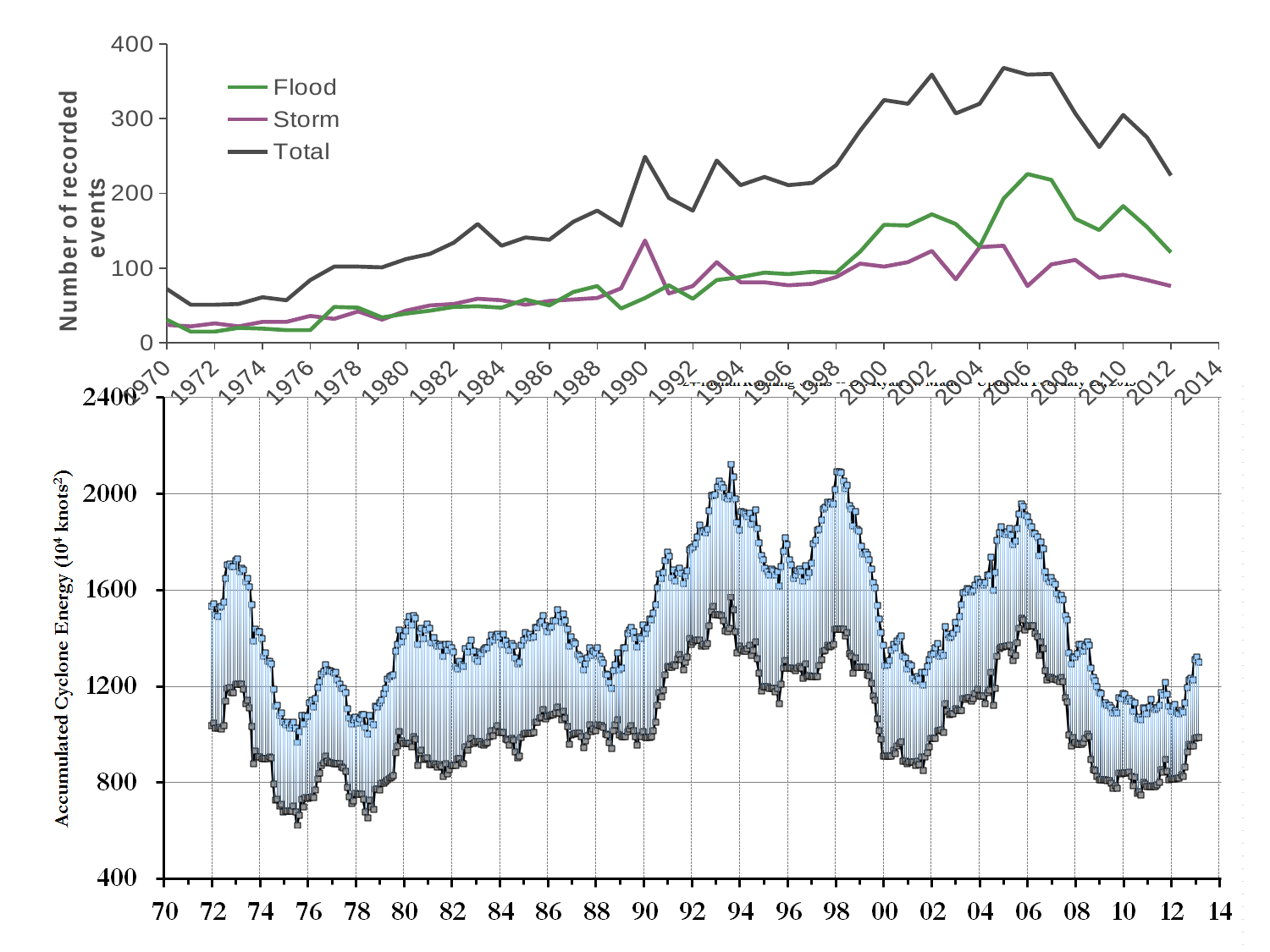
In the top chart, is the Storm value for 2012 greater or less than 100? less In the top chart, which is larger in 1990, the Flood value or the Storm value? Storm In the top chart, is the Total value for 2006 greater or less than 300? greater What is the y-axis label of the top chart? Number of recorded events In the top chart, which is larger in 2006, the Flood value or the Storm value? Flood In the top chart, is the Flood value for 1970 greater or less than 100? less In the top chart, what kind of chart is used to show the number of recorded events? line chart In the top chart, does the Total series generally rise or fall between 1970 and 2006? rise In the top chart, how many series does the legend list? 3 In the top chart, which series has the highest values throughout the period? Total